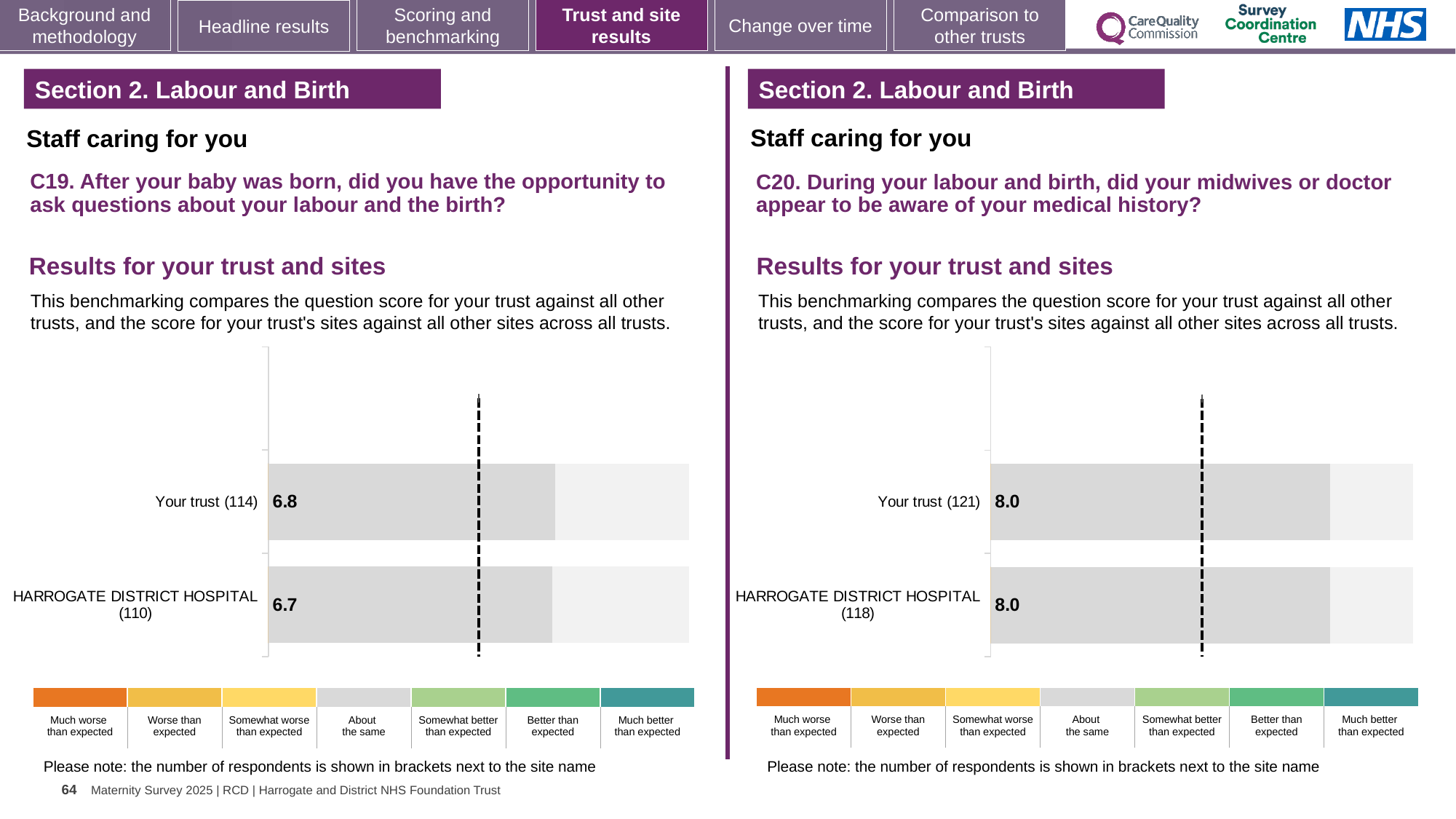
On the C19 chart (left), what is the difference between the score for Your trust and the score for HARROGATE DISTRICT HOSPITAL? 0.1 On the C19 chart (left), what is the score for Your trust? 6.8 On the C19 chart (left), what is the score for HARROGATE DISTRICT HOSPITAL? 6.7 What kind of chart is used on the C19 chart (left)? Bar chart On the C20 chart (right), how many respondents are shown in brackets for HARROGATE DISTRICT HOSPITAL? 118 On the C20 chart (right), how many categories does the colour key below the chart list? 7 On the C20 chart (right), how many bars are plotted? 2 On the C19 chart (left), what is the label of the middle category in the colour key below the chart? About the same On the C20 chart (right), what is the score for HARROGATE DISTRICT HOSPITAL? 8.0 On the C19 chart (left), which has the higher score, Your trust or HARROGATE DISTRICT HOSPITAL? Your trust On the C19 chart (left), how many respondents are shown in brackets for Your trust? 114 On the C20 chart (right), what is the score for Your trust? 8.0